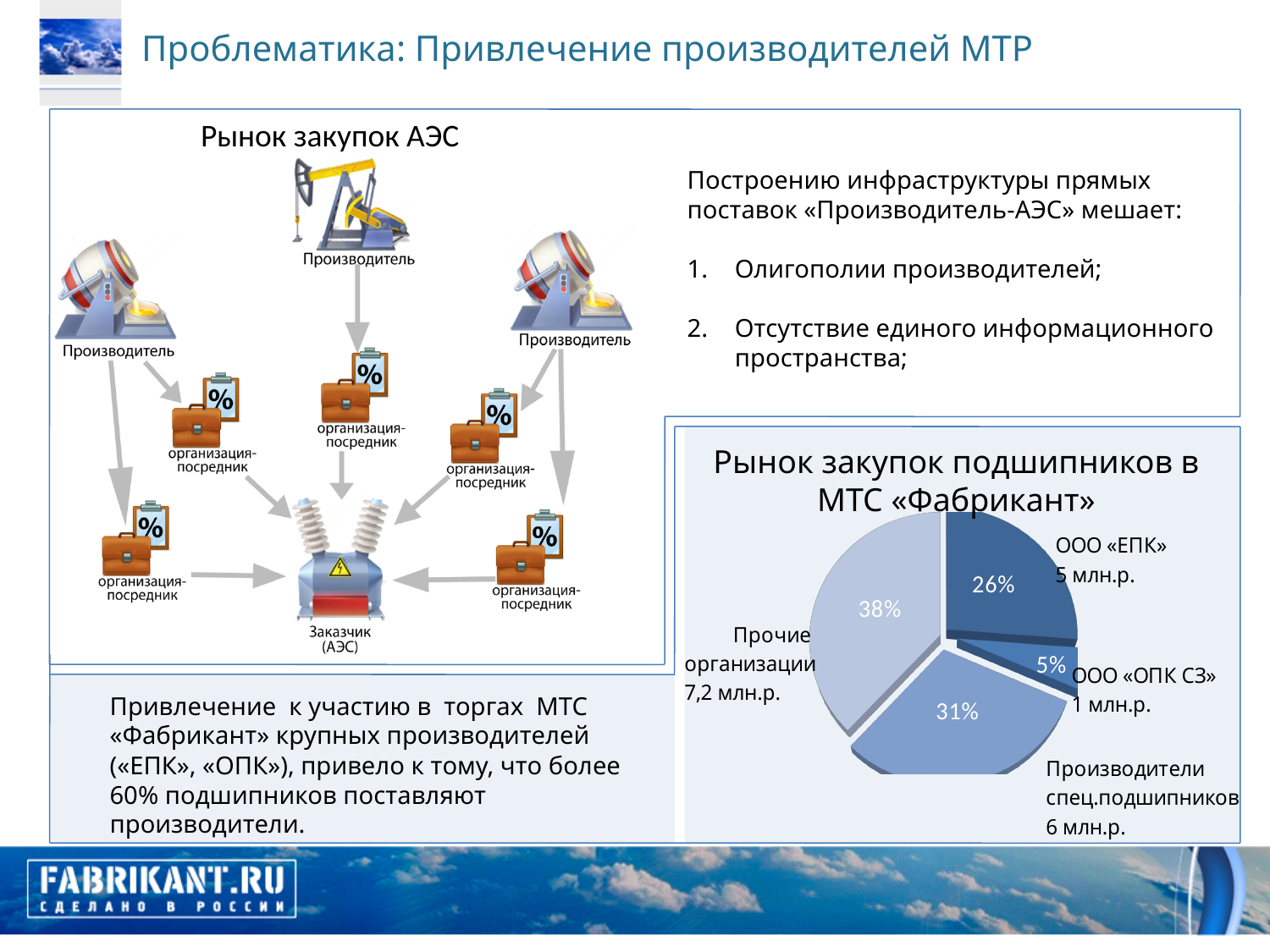
What kind of chart is shown on the slide? Pie chart What purchase amount is shown for Прочие организации? 7,2 млн.р. Which slice of the pie chart is the largest? Прочие организации What share of the pie does ООО «ОПК СЗ» hold? 5% Which is larger: the share of ООО «ЕПК» or the share of Производители спец.подшипников? Производители спец.подшипников How many slices does the pie chart have? 4 What share of the pie does ООО «ЕПК» hold? 26% What purchase amount is shown for ООО «ЕПК»? 5 млн.р. What share of the pie do Прочие организации hold? 38% Which slice of the pie chart is the smallest? ООО «ОПК СЗ» What is the title of the pie chart? Рынок закупок подшипников в МТС «Фабрикант»